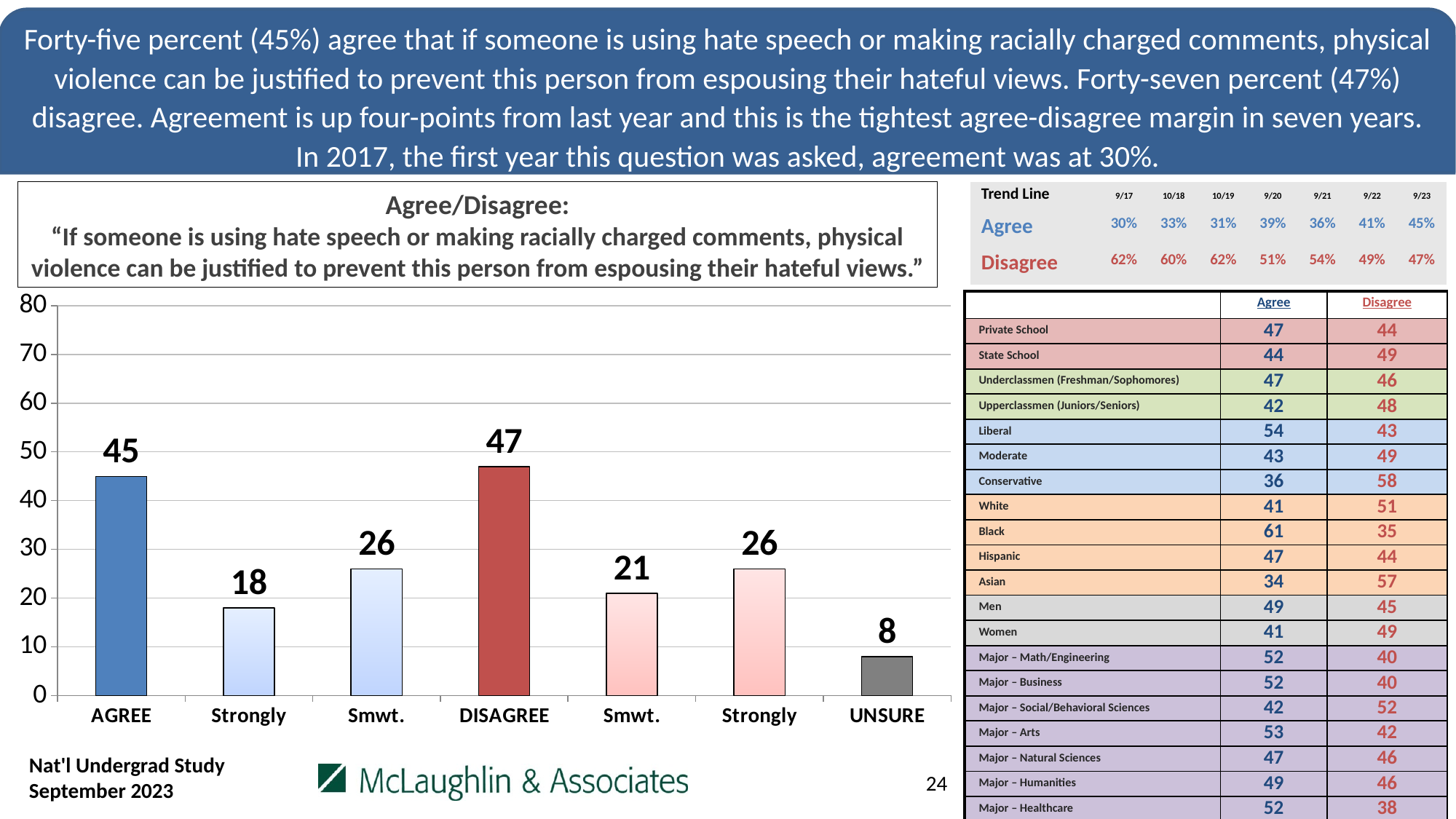
Which category has the lowest bar? UNSURE Which is larger, the AGREE bar or the DISAGREE bar? DISAGREE What is the value of the 'Strongly' bar immediately to the right of AGREE (the second bar from the left)? 18 What is the value of the UNSURE bar? 8 What kind of chart is shown on the slide? bar chart What is the difference between the DISAGREE and AGREE values? 2 Is the value for AGREE greater or less than 40? greater What is the value of the AGREE bar? 45 How many bars are shown in the chart? 7 What is the value of the 'Smwt.' bar immediately to the right of DISAGREE (the fifth bar from the left)? 21 Which category has the highest bar? DISAGREE What is the value of the DISAGREE bar? 47